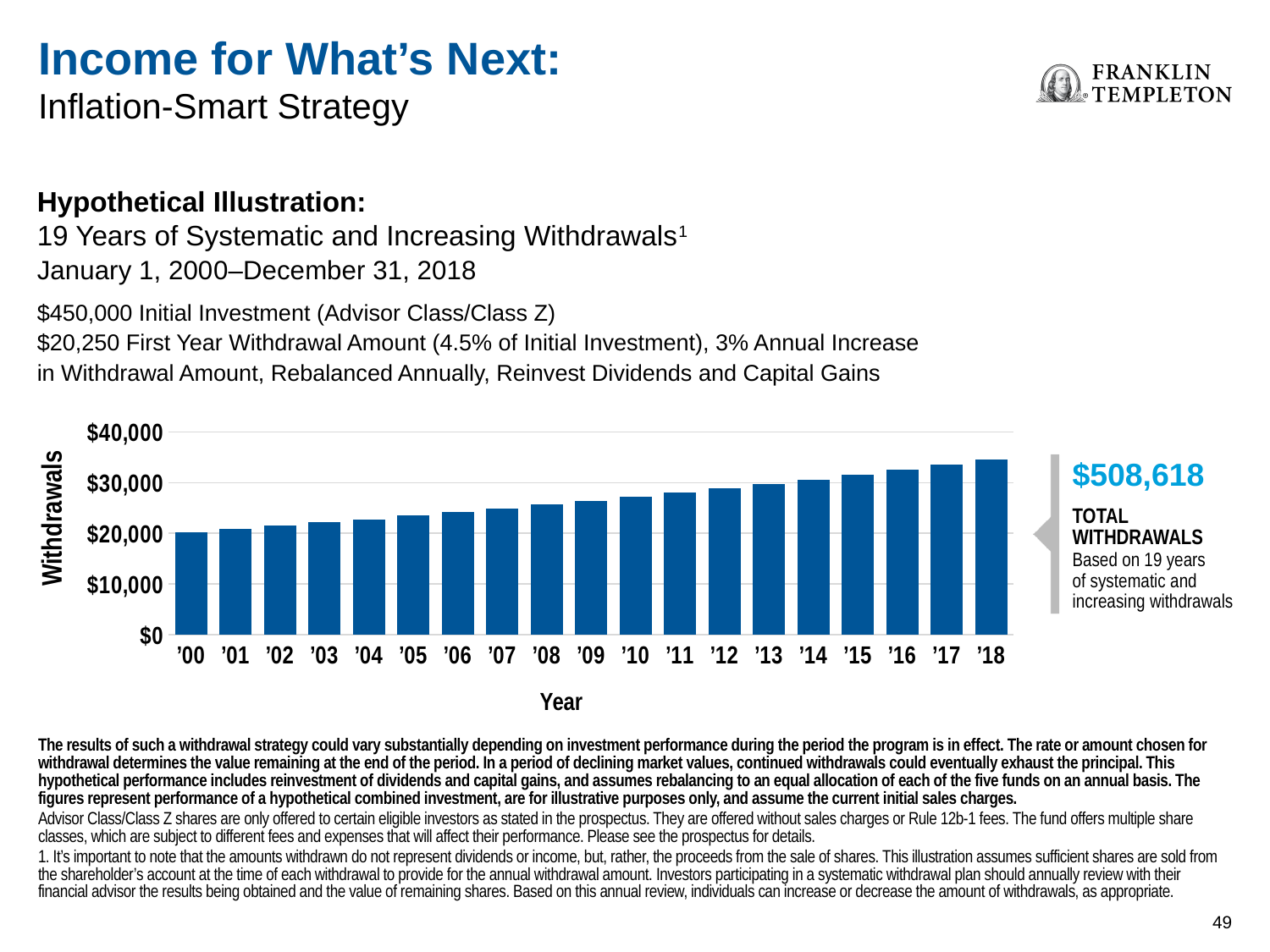
Is the withdrawal value for '10 greater or less than $20,000? greater Is the withdrawal value for '18 greater or less than $40,000? less What is the label on the vertical axis of the chart? Withdrawals Is the withdrawal value for '00 greater or less than $30,000? less What kind of chart is shown on the slide? bar chart How many years (bars) are plotted in the chart? 19 Which year has the lowest withdrawal amount in the chart? '00 Which year has the highest withdrawal amount in the chart? '18 Which year has the larger withdrawal amount, '05 or '15? '15 What total withdrawals figure is shown in the callout next to the chart? $508,618 Do the withdrawal amounts rise or fall from '00 to '18? rise